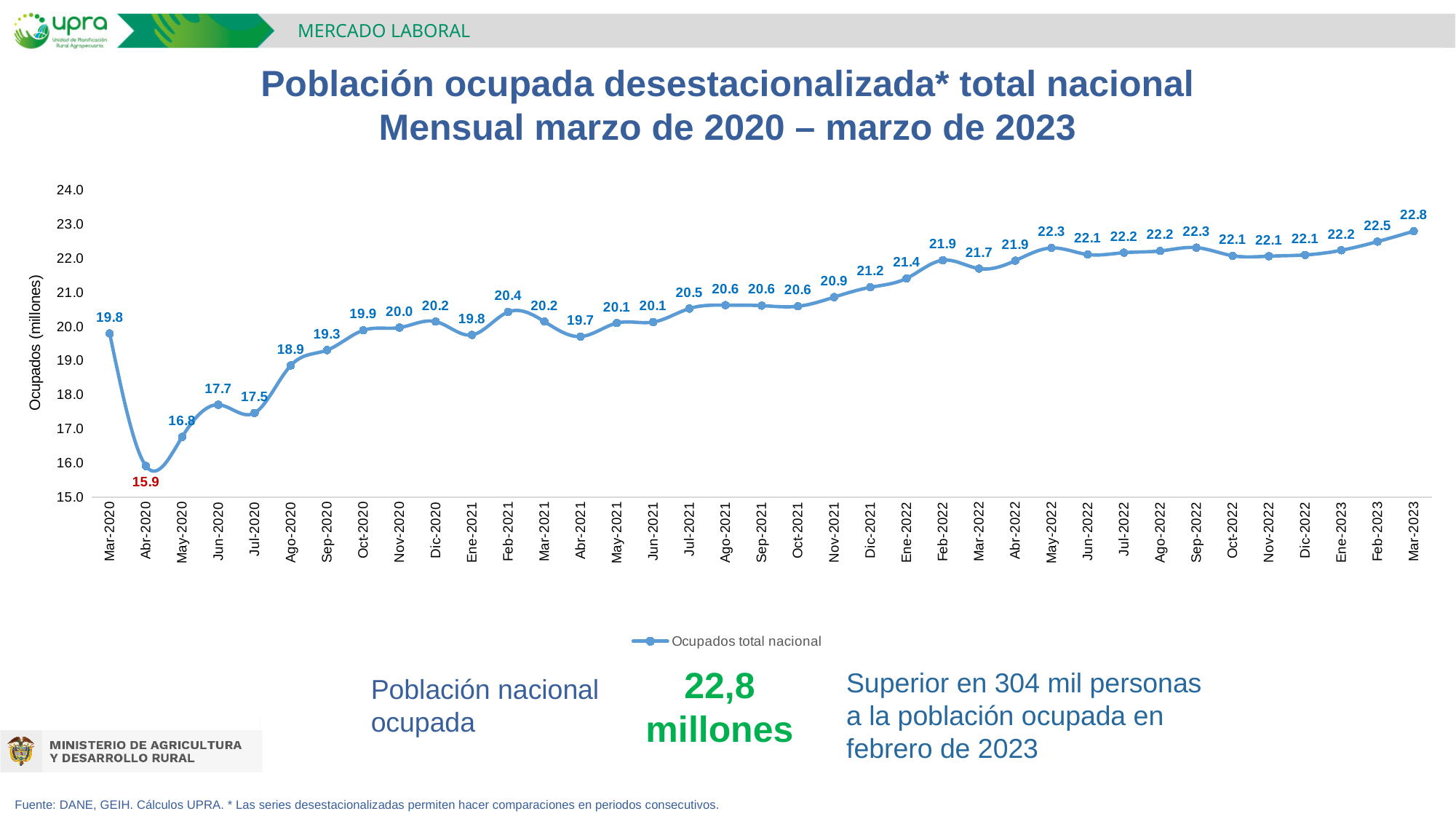
Which month has the highest value on the chart? Mar-2023 Which is larger, the value for Feb-2022 or the value for Mar-2022? Feb-2022 Which month has the lowest value on the chart? Abr-2020 What is the difference between the values for Mar-2023 and Abr-2020? 6.9 Do the values generally rise or fall from Abr-2020 to Mar-2023? Rise How many series does the legend list? 1 What is the value for Abr-2020? 15.9 What is the value for Mar-2023? 22.8 How many monthly data points are plotted on the chart? 37 What is the label of the y axis? Ocupados (millones) What type of chart is shown on the slide? Line chart What is the value for Dic-2021? 21.2